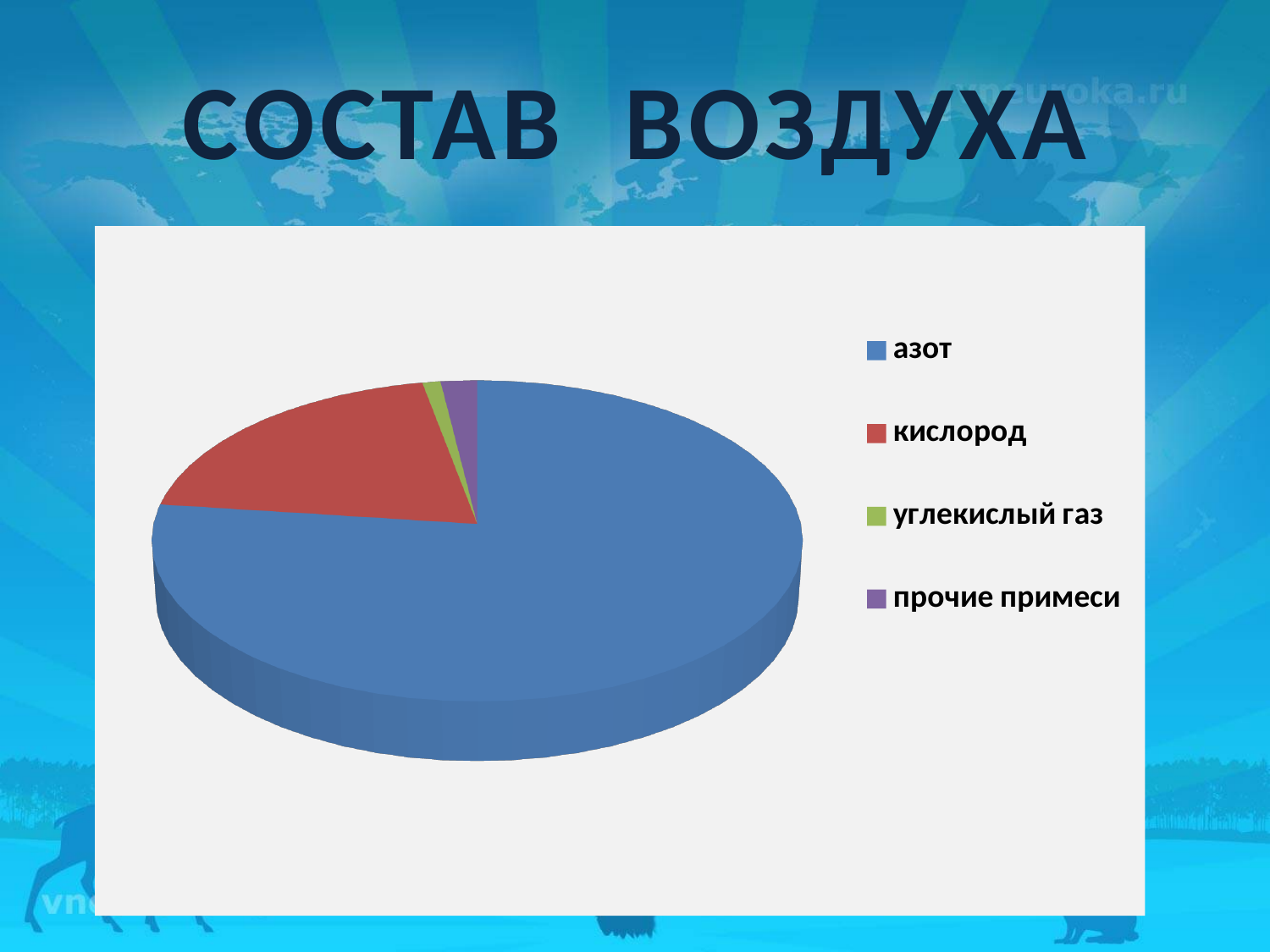
Which category has the largest slice of the pie chart? азот What colour is the slice for азот in the pie chart? blue How many categories (slices) does the pie chart have? 4 Which slice is larger, кислород or углекислый газ? кислород Which slice is larger, азот or кислород? азот What is the title of the slide containing the pie chart? СОСТАВ ВОЗДУХА Which category has the second-largest slice of the pie chart? кислород What kind of chart is shown on the slide? pie chart Which category has the smallest slice of the pie chart? углекислый газ